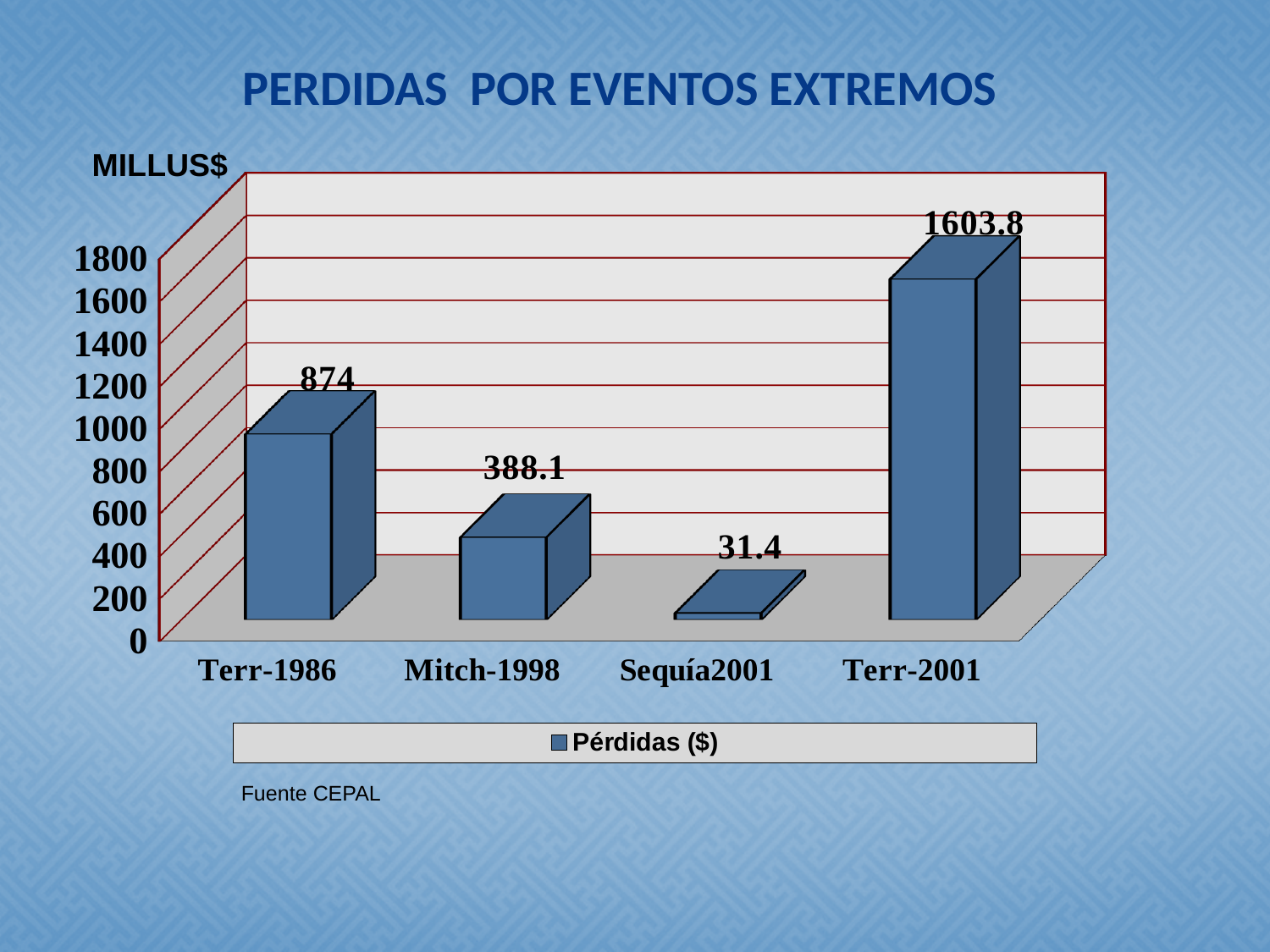
What is the difference between the values for Terr-2001 and Terr-1986? 729.8 What is the value for Mitch-1998? 388.1 What is the value for Sequía2001? 31.4 Which event has the highest losses? Terr-2001 Which event has the lowest losses? Sequía2001 How many events are shown on the chart? 4 What series does the legend list? Pérdidas ($) What is the value for Terr-2001? 1603.8 What is the value for Terr-1986? 874 Which is larger, the value for Terr-1986 or the value for Mitch-1998? Terr-1986 What kind of chart is shown on the slide? Bar chart What is the difference between the values for Mitch-1998 and Sequía2001? 356.7